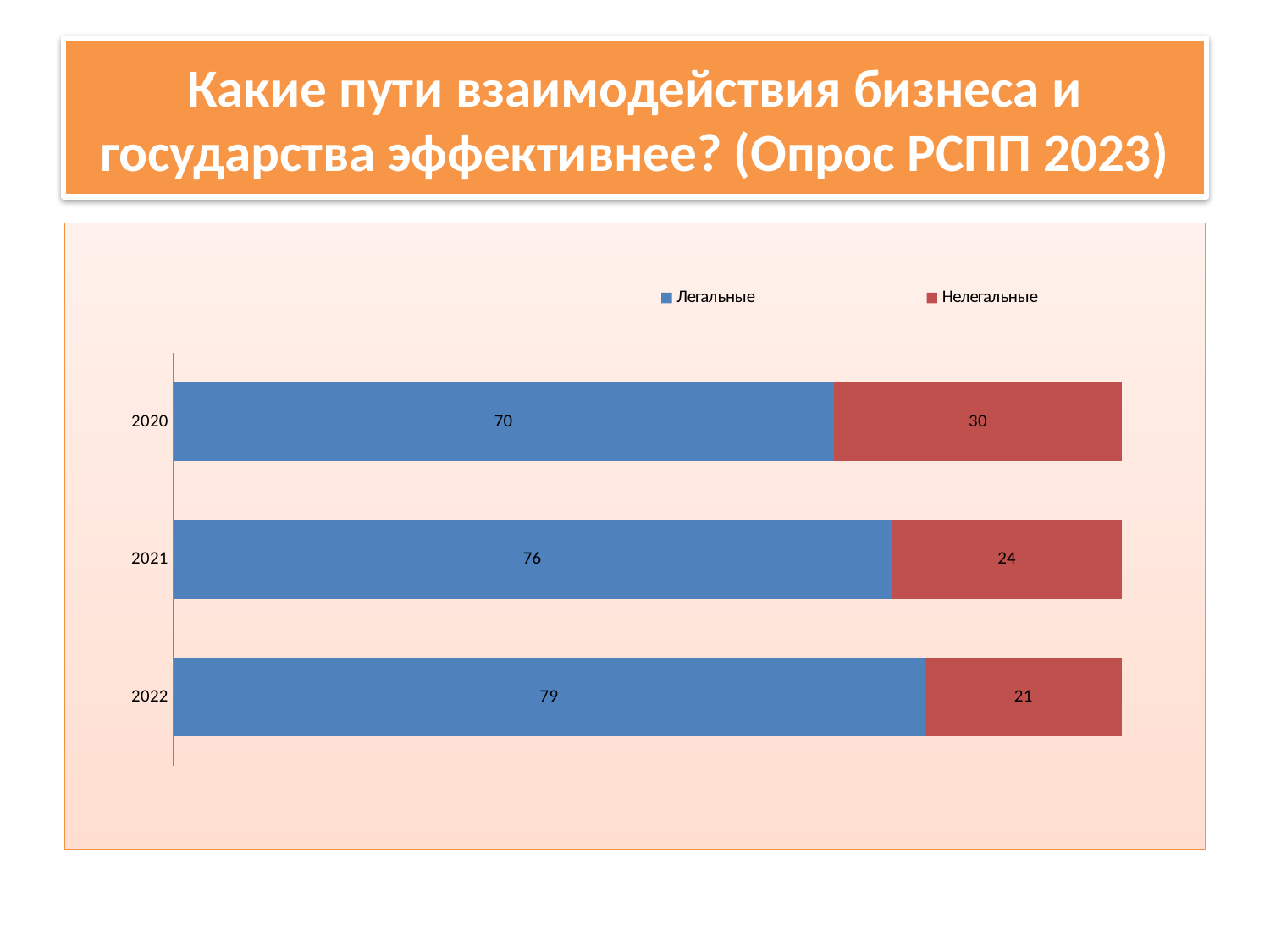
How many years are shown on the chart? 3 What is the value for Легальные in 2020? 70 Which series is shown in red? Нелегальные How many series does the legend list? 2 What is the total of the stacked bar for 2021? 100 What is the difference between the Легальные values for 2022 and 2020? 9 What is the value for Нелегальные in 2021? 24 What is the value for Нелегальные in 2022? 21 Which is larger: the Нелегальные value for 2020 or for 2021? 2020 In which year is the value for Легальные highest? 2022 What kind of chart is shown on the slide? Stacked bar chart In which year is the value for Нелегальные lowest? 2022